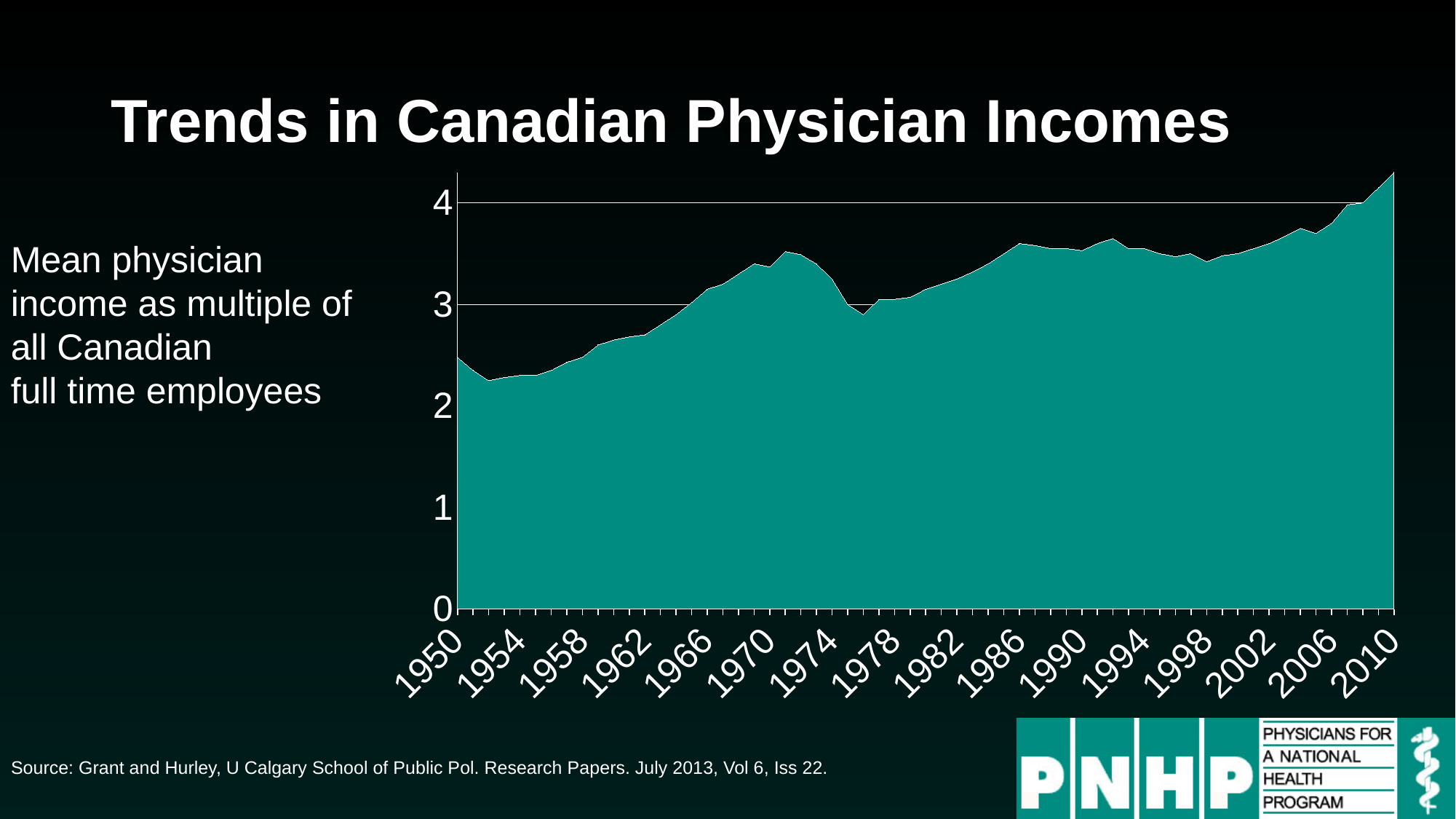
Overall, do the values rise or fall from 1950 to 2010? Rise Which is larger, the value for 1986 or the value for 1978? 1986 What is the title of the slide's chart? Trends in Canadian Physician Incomes Is the value for 1970 greater or less than 3? greater What does the chart's plotted value represent, according to the text on the slide? Mean physician income as multiple of all Canadian full time employees Is the value for 1950 greater or less than 3? less Which labeled year has the highest value on the chart? 2010 Is the value for 1954 greater or less than 2? greater What kind of chart is shown on the slide? Area chart How many year labels are shown on the x axis? 16